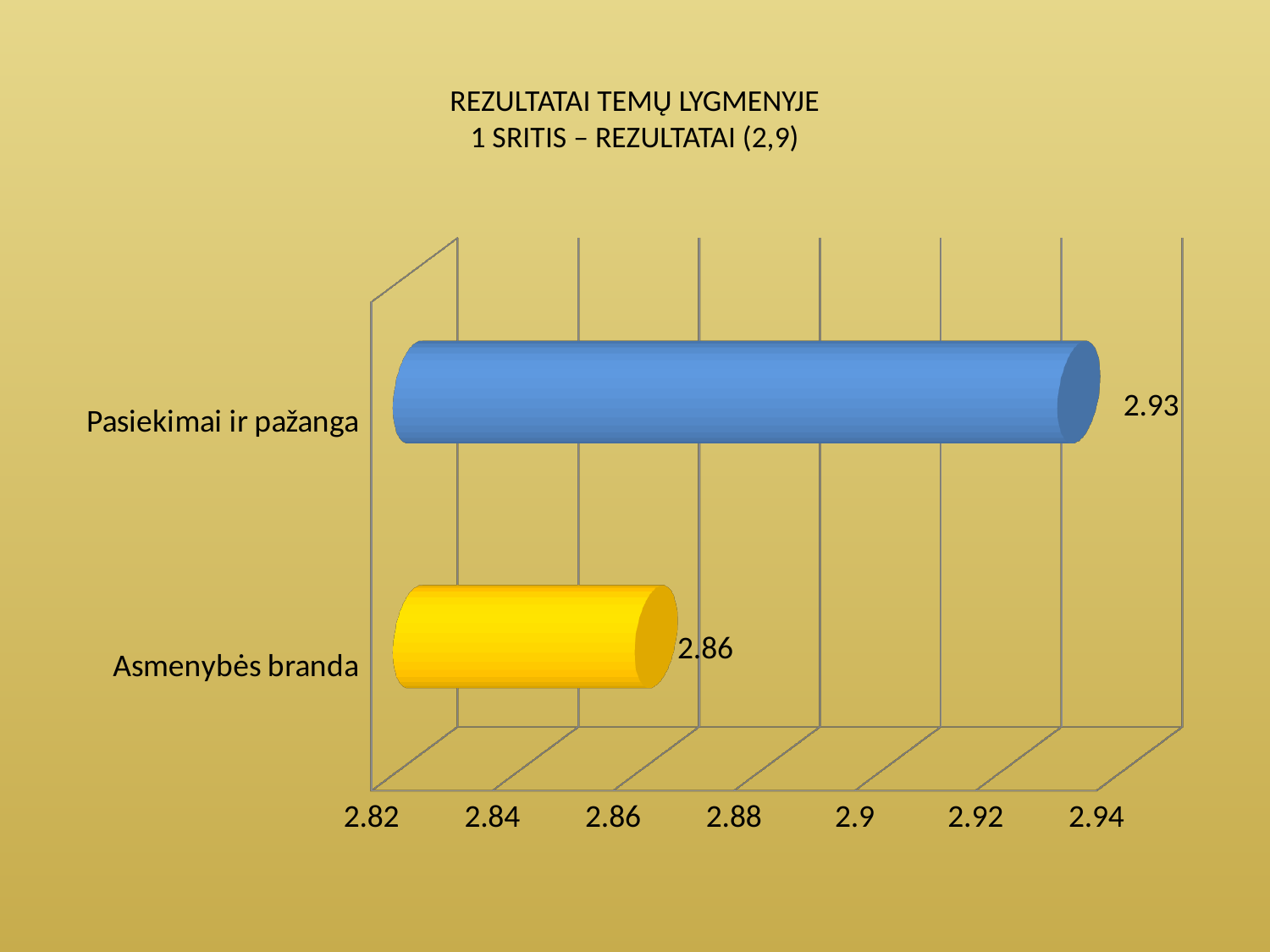
Which category has the lowest value? Asmenybės branda How many categories are shown in the chart? 2 What is the value for Pasiekimai ir pažanga? 2.93 Is the value for Pasiekimai ir pažanga greater or less than 2.9? greater Which category has the highest value? Pasiekimai ir pažanga What kind of chart is shown on the slide? bar chart What colour is the bar for Asmenybės branda? yellow Which is larger, the value for Pasiekimai ir pažanga or the value for Asmenybės branda? Pasiekimai ir pažanga What is the value for Asmenybės branda? 2.86 What is the title of the chart? REZULTATAI TEMŲ LYGMENYJE 1 SRITIS – REZULTATAI (2,9) What is the difference between the values for Pasiekimai ir pažanga and Asmenybės branda? 0.07 Is the value for Asmenybės branda greater or less than 2.88? less